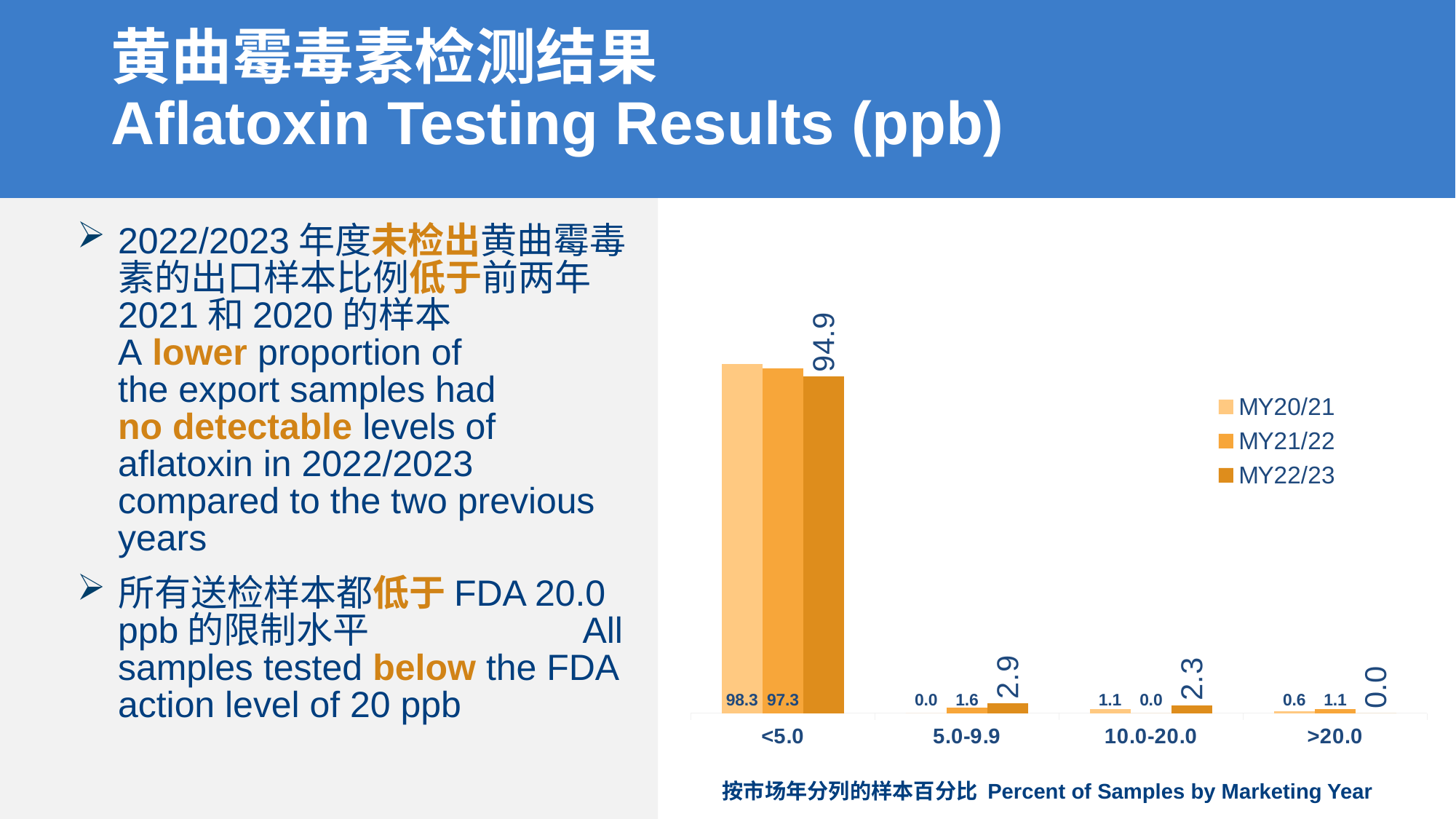
What is the value for MY21/22 in the 5.0-9.9 category? 1.6 How many series does the legend list? 3 What is the value for MY22/23 in the <5.0 category? 94.9 What is the value for MY22/23 in the >20.0 category? 0.0 What is the caption shown below the chart in English? Percent of Samples by Marketing Year How many categories are shown on the x axis? 4 Which marketing year has the lowest value in the 10.0-20.0 category? MY21/22 What is the value for MY20/21 in the <5.0 category? 98.3 Which is larger in the 5.0-9.9 category: MY21/22 or MY22/23? MY22/23 What kind of chart is shown on the slide? Bar chart Which marketing year has the highest value in the <5.0 category? MY20/21 What is the difference between the MY20/21 and MY22/23 values in the <5.0 category? 3.4